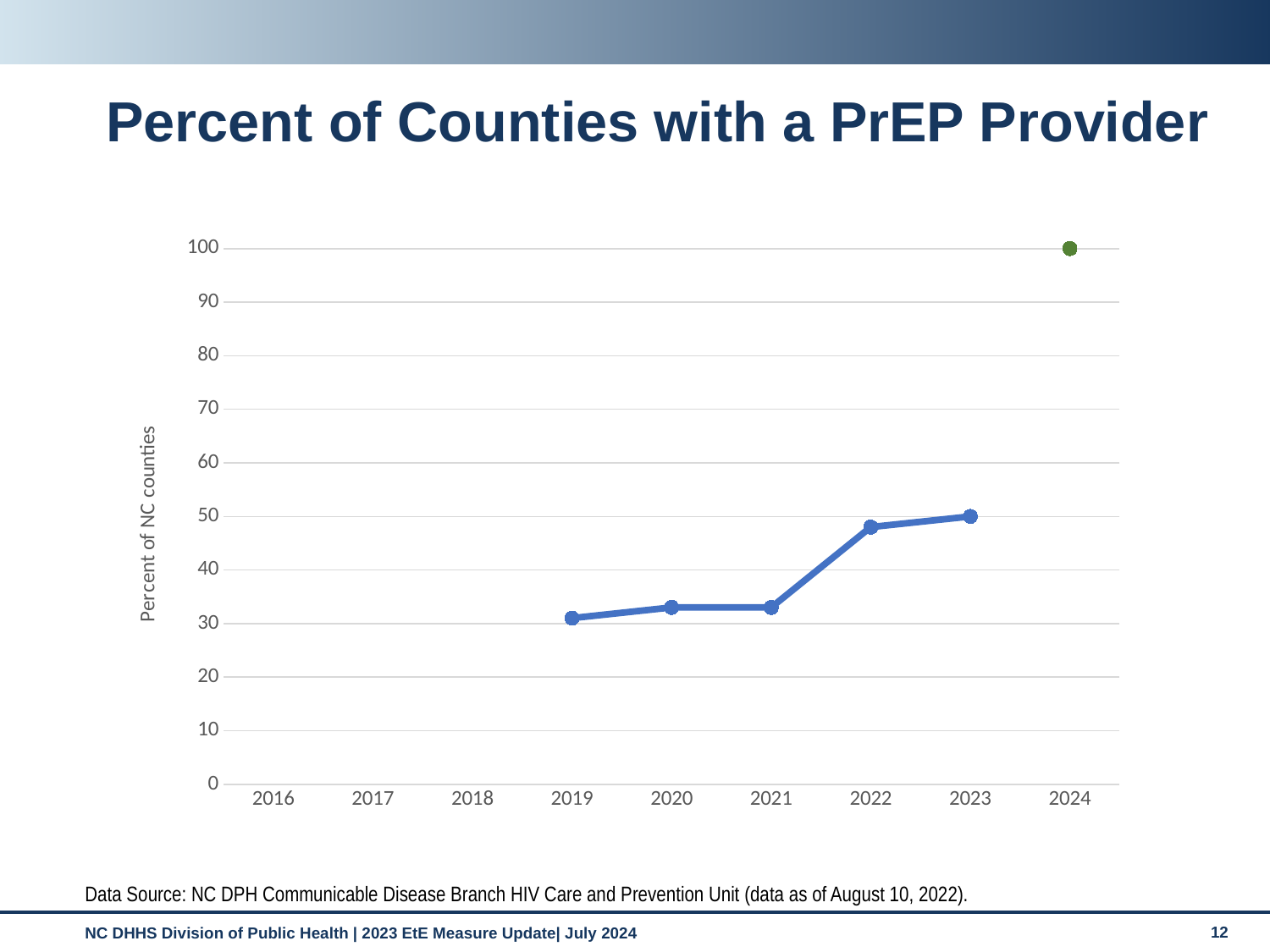
What kind of chart is shown on the slide? line chart Is the value for 2021 greater or less than 30? greater Which year has the highest plotted value? 2024 What is the title of the chart? Percent of Counties with a PrEP Provider Is the value for 2022 greater or less than 40? greater Which year has the lowest plotted value? 2019 What is the label on the vertical axis? Percent of NC counties What is the value plotted for 2023? 50 Which year has the larger value, 2019 or 2022? 2022 Is the value for 2019 greater or less than 40? less How many years are labeled on the x axis? 9 What is the value plotted for 2024? 100